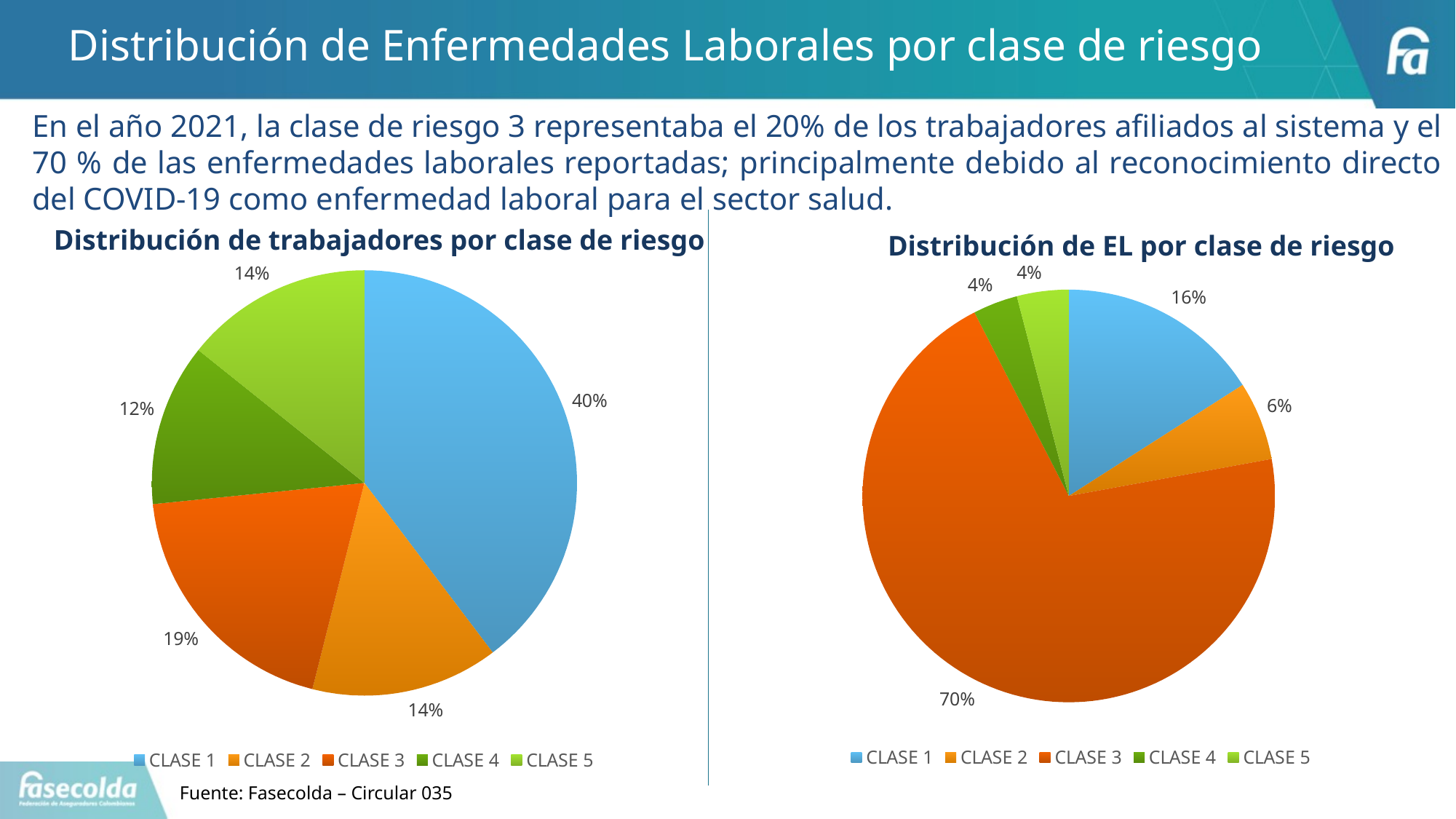
In the chart 'Distribución de trabajadores por clase de riesgo', what is the difference between the shares of CLASE 1 and CLASE 3? 21% In the chart 'Distribución de trabajadores por clase de riesgo', what share does CLASE 1 have? 40% In the chart 'Distribución de trabajadores por clase de riesgo', which class has the smallest share? CLASE 4 How many classes does the legend of the chart 'Distribución de trabajadores por clase de riesgo' list? 5 In the chart 'Distribución de EL por clase de riesgo', which class has the largest share? CLASE 3 In the chart 'Distribución de trabajadores por clase de riesgo', which class has the largest share? CLASE 1 What kind of chart is 'Distribución de EL por clase de riesgo'? Pie chart In the chart 'Distribución de EL por clase de riesgo', what share does CLASE 3 have? 70% In the chart 'Distribución de EL por clase de riesgo', what share does CLASE 2 have? 6% In the chart 'Distribución de EL por clase de riesgo', what is the difference between the shares of CLASE 3 and CLASE 1? 54%